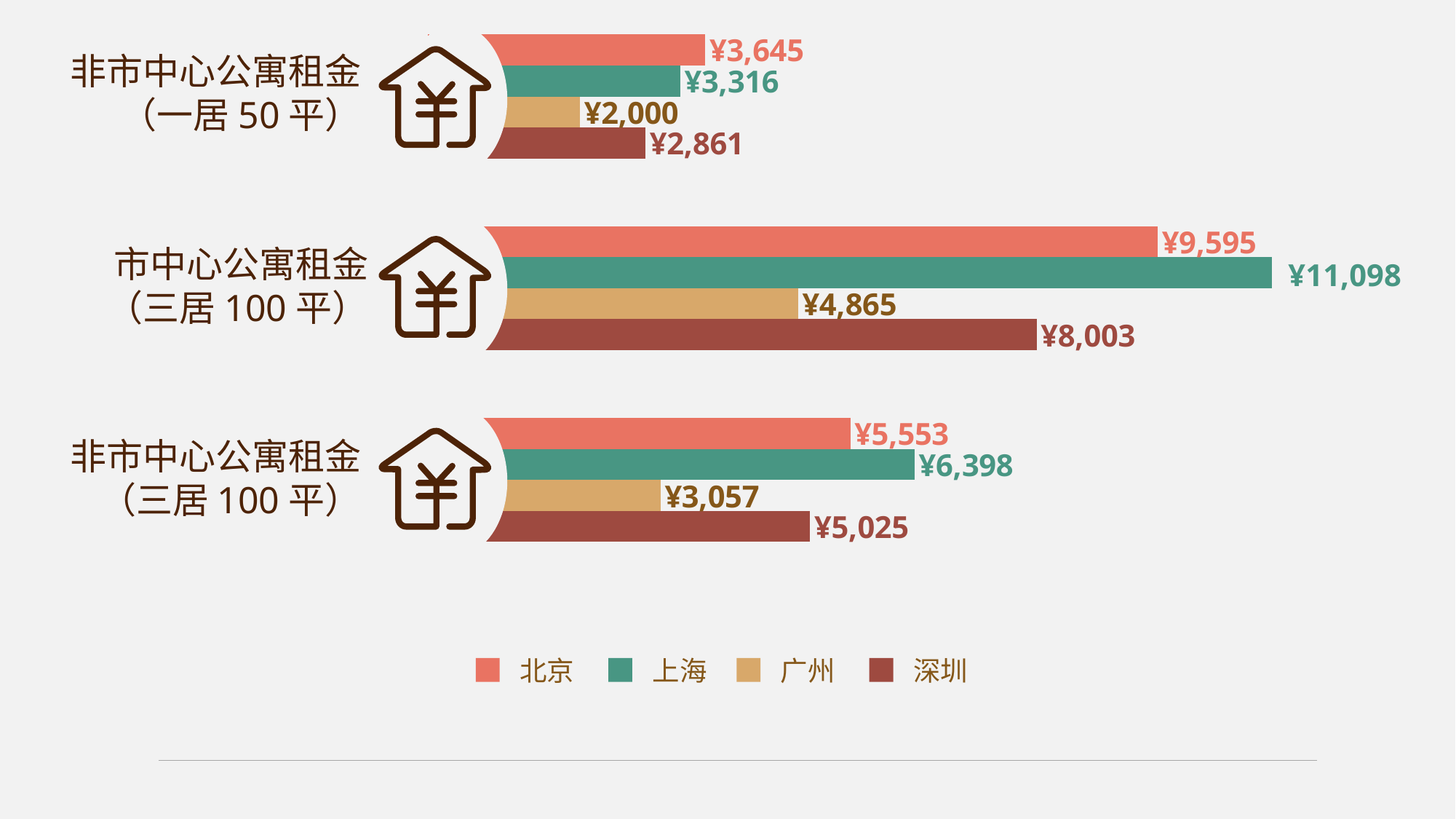
Which city has the highest value in the 市中心公寓租金（三居 100 平） category? 上海 What is the difference between the 上海 and 北京 values in the 非市中心公寓租金（三居 100 平） category? ¥845 Which city has the lowest value in the 非市中心公寓租金（一居 50 平） category? 广州 How many series does the legend list? 4 How many categories are shown in the chart? 3 What is the value for 上海 in the 市中心公寓租金（三居 100 平） category? ¥11,098 Which colour represents 广州 in the legend? Tan/gold What is the value for 深圳 in the 市中心公寓租金（三居 100 平） category? ¥8,003 In the 非市中心公寓租金（一居 50 平） category, which is larger: the value for 上海 or the value for 深圳? 上海 What kind of chart is shown on the slide? Bar chart What is the value for 广州 in the 非市中心公寓租金（三居 100 平） category? ¥3,057 What is the value for 北京 in the 非市中心公寓租金（一居 50 平） category? ¥3,645